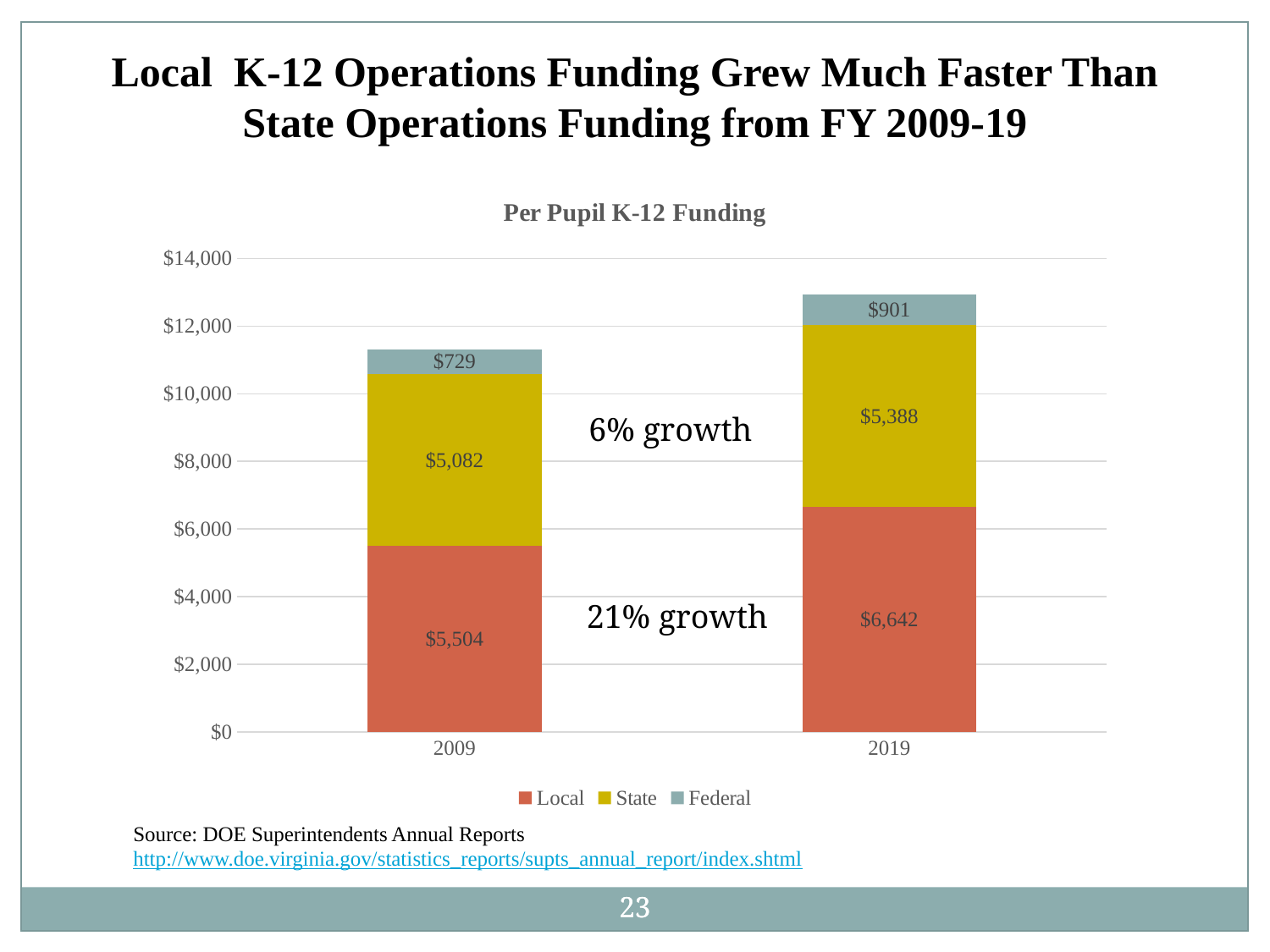
What is the Federal per pupil funding value for 2009? $729 Which is larger: Local funding in 2009 or State funding in 2009? Local funding in 2009 What is the Federal per pupil funding value for 2019? $901 What is the Local per pupil funding value for 2009? $5,504 What is the total per pupil funding for 2019 (sum of Local, State and Federal)? $12,931 How many series does the legend list? 3 By how much did Local per pupil funding increase from 2009 to 2019? $1,138 What is the State per pupil funding value for 2019? $5,388 Which series has the highest value in 2009? Local Which series has the lowest value in 2019? Federal What is the difference between State funding in 2019 and State funding in 2009? $306 What type of chart is shown on the slide? Stacked bar chart